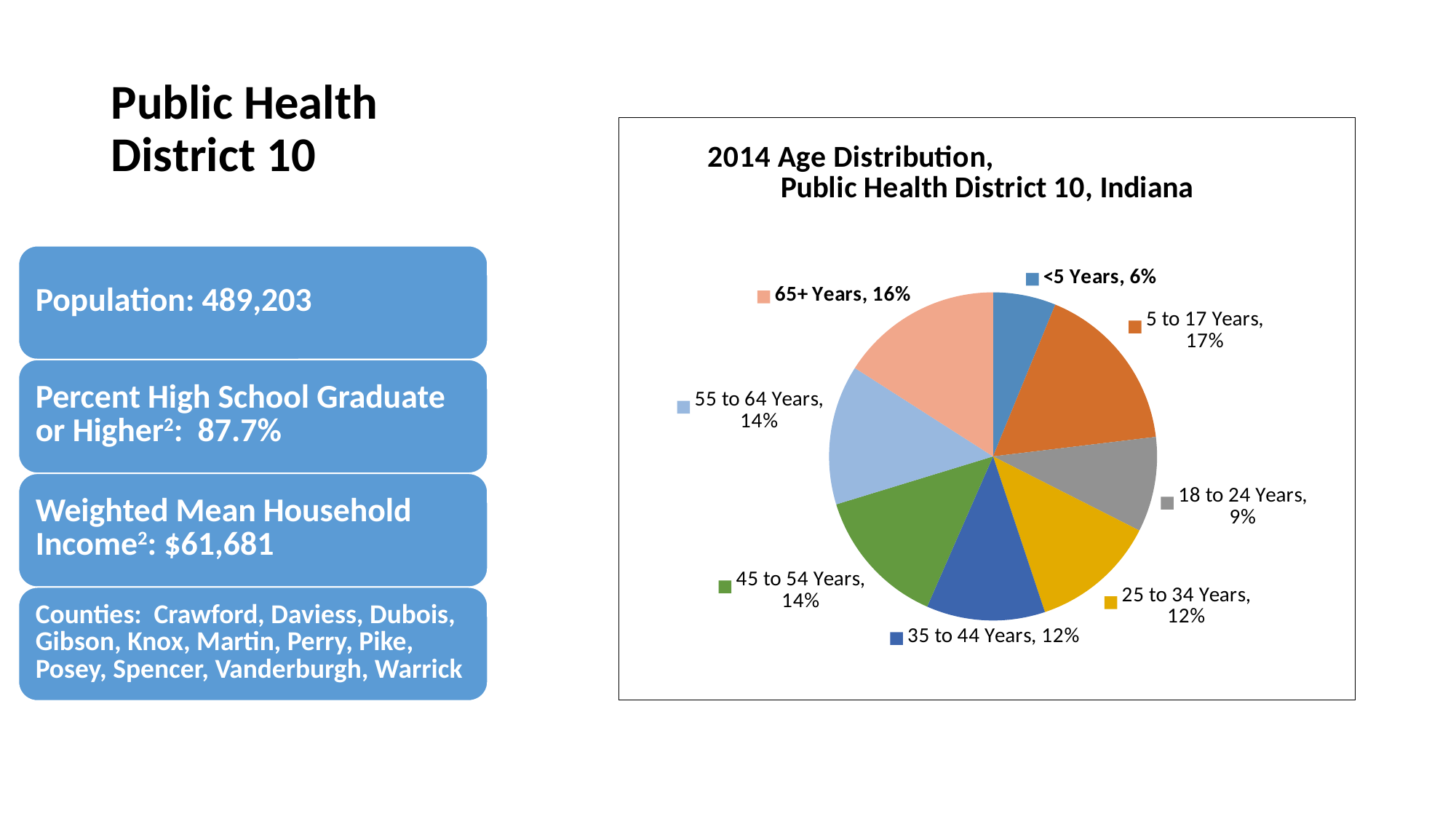
What percentage of the population is 18 to 24 Years? 9% What is the title of the chart? 2014 Age Distribution, Public Health District 10, Indiana What type of chart is shown on the slide? Pie chart What percentage of the population is 65+ Years? 16% Which age group has the largest share of the pie? 5 to 17 Years How many age groups are shown in the pie chart? 8 Which age group has the smallest share of the pie? <5 Years What percentage of the population is 5 to 17 Years? 17% What is the difference in percentage points between the 65+ Years slice and the 18 to 24 Years slice? 7 What is the combined share of the 25 to 34 Years and 35 to 44 Years slices? 24% Which is larger, the share for 55 to 64 Years or the share for 35 to 44 Years? 55 to 64 Years What percentage of the population is <5 Years? 6%